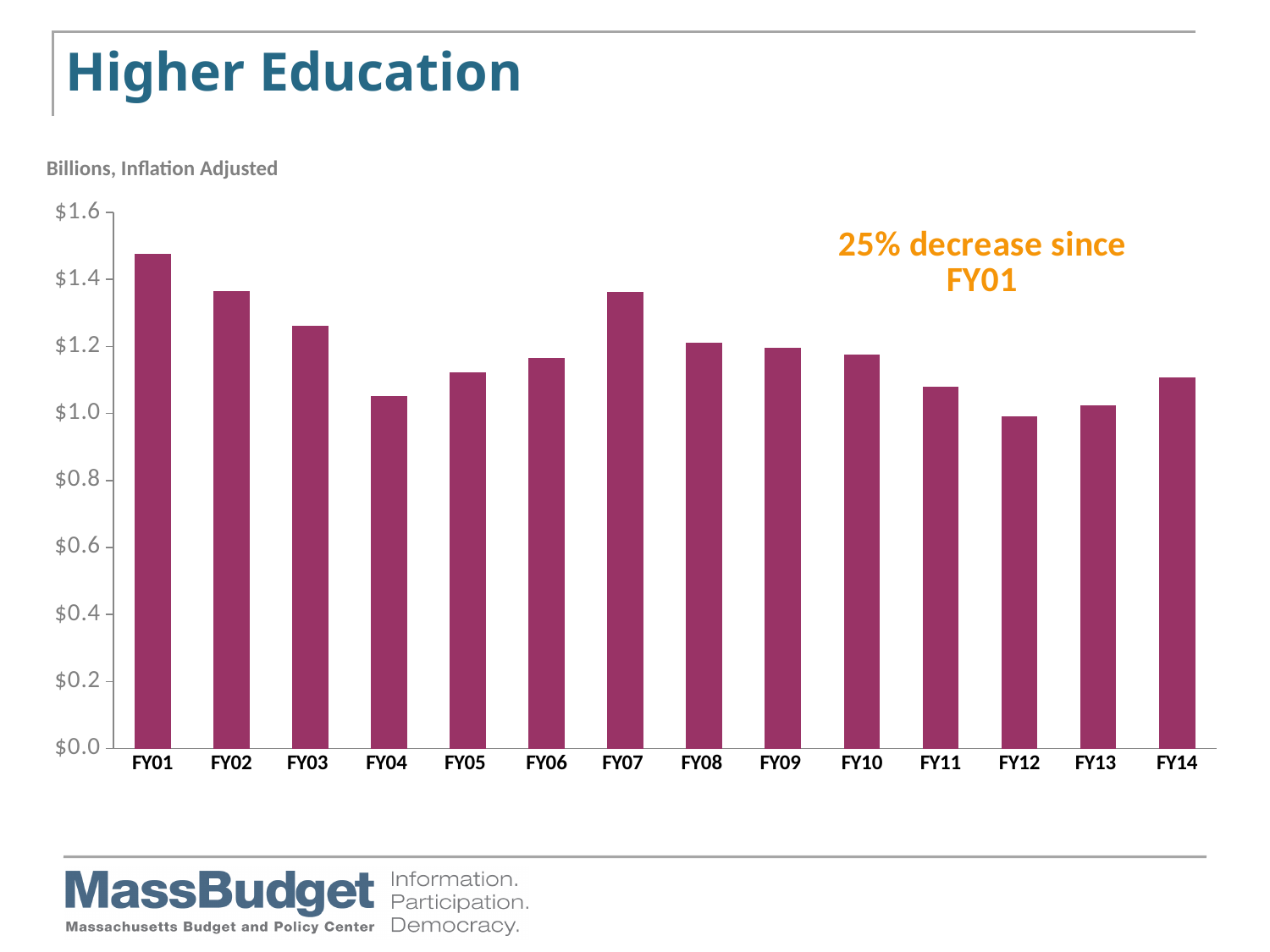
Is the value for FY07 greater or less than $1.2? greater Which fiscal year has the lowest value? FY12 Is the value for FY04 greater or less than $1.2? less How many fiscal years are plotted on the chart? 14 Which fiscal year has the highest value? FY01 Overall, do the values rise or fall from FY01 to FY14? fall What percentage decrease since FY01 does the annotation on the chart state? 25% Which is larger, the value for FY07 or the value for FY08? FY07 Is the value for FY01 greater or less than $1.4? greater What kind of chart is shown on the slide? bar chart Which is larger, the value for FY01 or the value for FY14? FY01